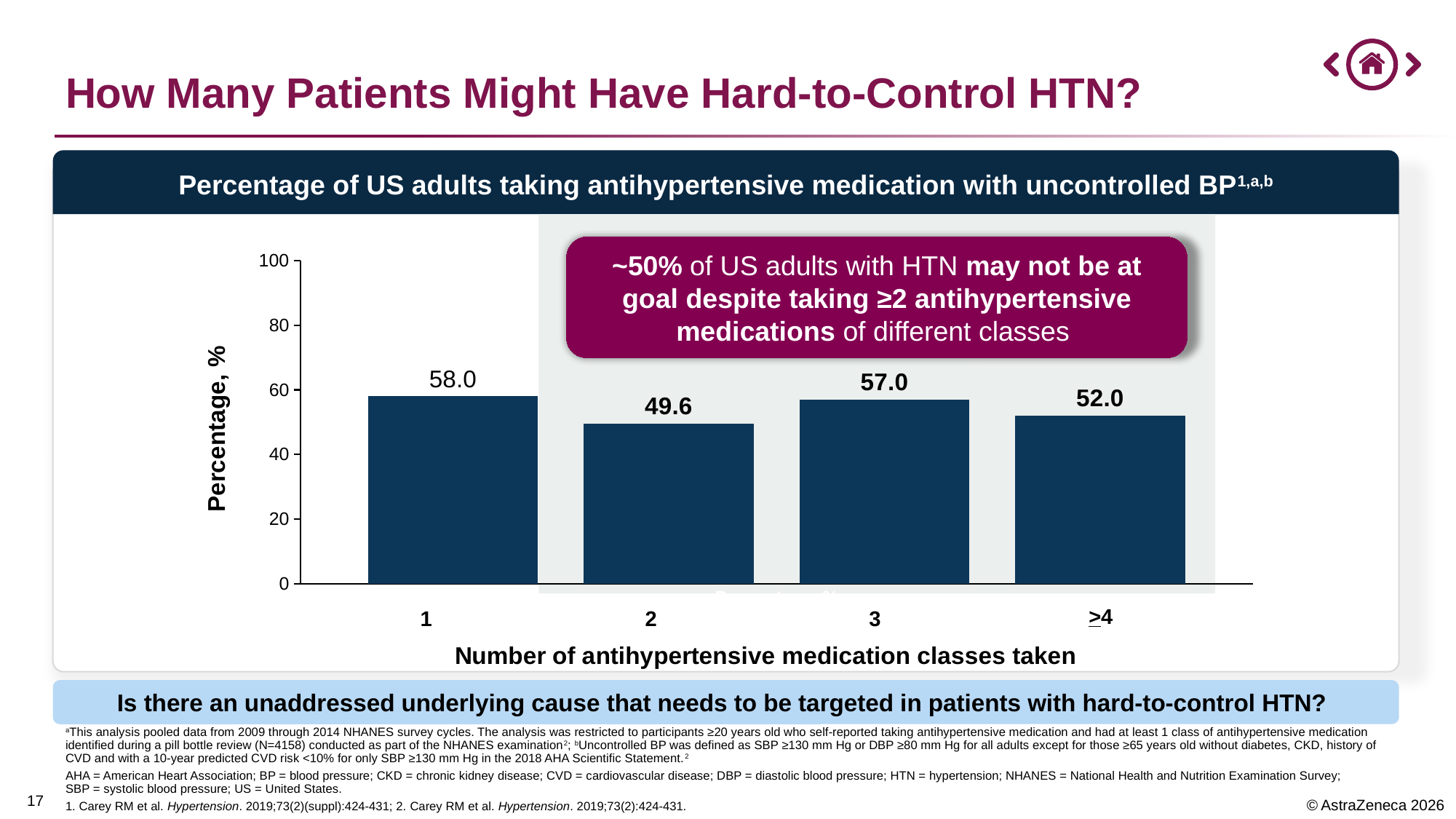
What is the value for patients taking 3 antihypertensive medication classes? 57.0 How many categories are shown on the x axis? 4 What is the label of the y axis? Percentage, % What percentage of US adults taking 1 antihypertensive medication class have uncontrolled BP? 58.0 Which is larger, the value for 3 classes or the value for ≥4 classes? 3 classes Which number of medication classes has the highest percentage with uncontrolled BP? 1 What kind of chart is shown on the slide? bar chart What is the difference between the values for 1 class and 2 classes? 8.4 What is the value for patients taking 2 antihypertensive medication classes? 49.6 What is the value for patients taking ≥4 antihypertensive medication classes? 52.0 Which number of medication classes has the lowest percentage with uncontrolled BP? 2 Is the value for 2 classes greater or less than 60? less